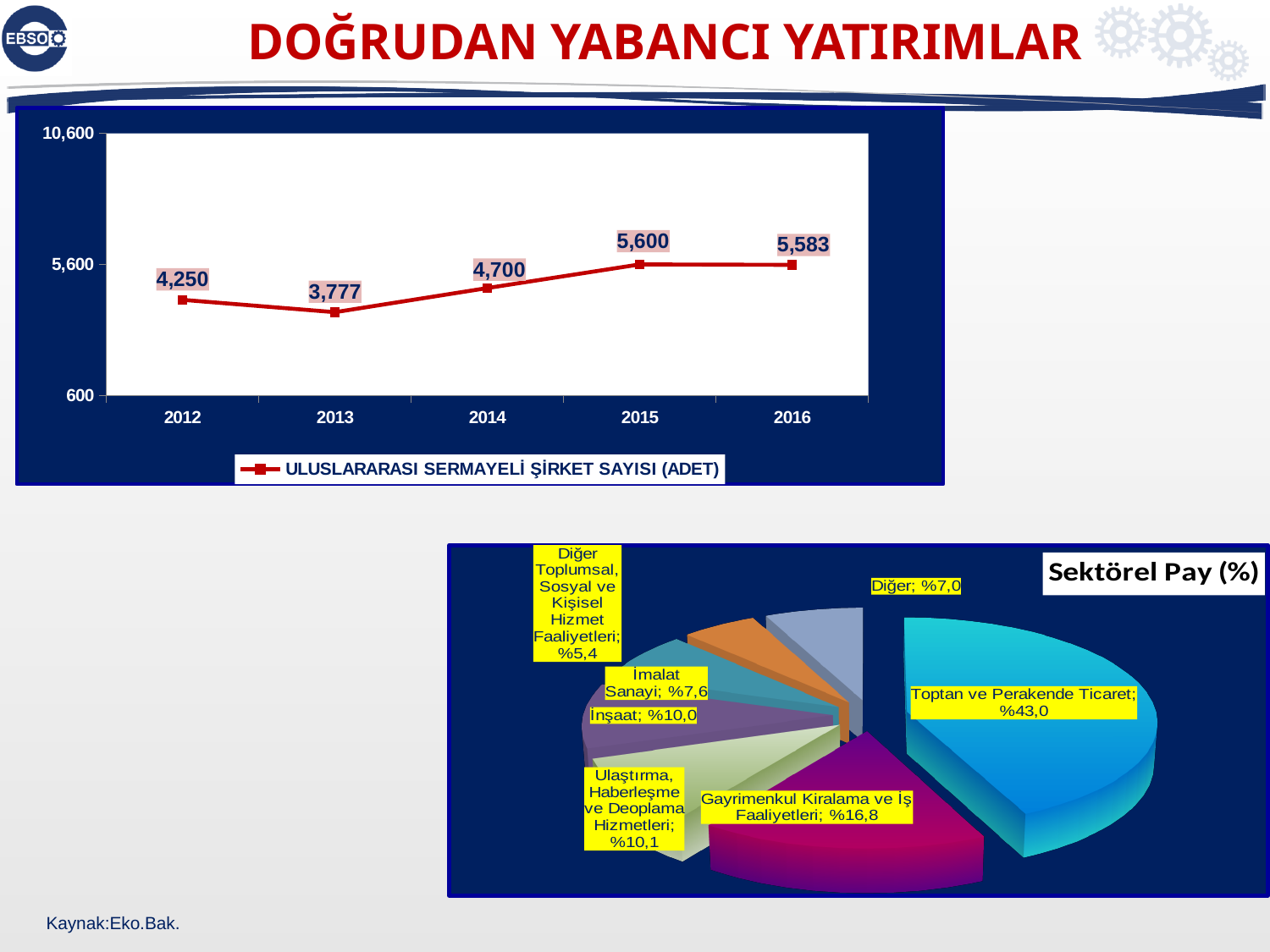
What kind of chart is the top chart on the slide? line chart In the top line chart, what series name does the legend show? ULUSLARARASI SERMAYELİ ŞİRKET SAYISI (ADET) In the 'Sektörel Pay (%)' pie chart, which sector has the smallest share? Diğer Toplumsal, Sosyal ve Kişisel Hizmet Faaliyetleri In the 'Sektörel Pay (%)' pie chart, what is the share for Toptan ve Perakende Ticaret? %43,0 In the top line chart, how many years are plotted on the x axis? 5 In the top line chart, what is the value for 2013? 3,777 In the 'Sektörel Pay (%)' pie chart, how many slices are there? 7 In the top line chart, which year has the lowest value? 2013 In the top line chart, which year has the highest value? 2015 In the top line chart, what is the difference between the 2015 value and the 2012 value? 1,350 In the top line chart, does the value rise or fall from 2013 to 2015? rise In the top line chart, what is the value for 2016? 5,583